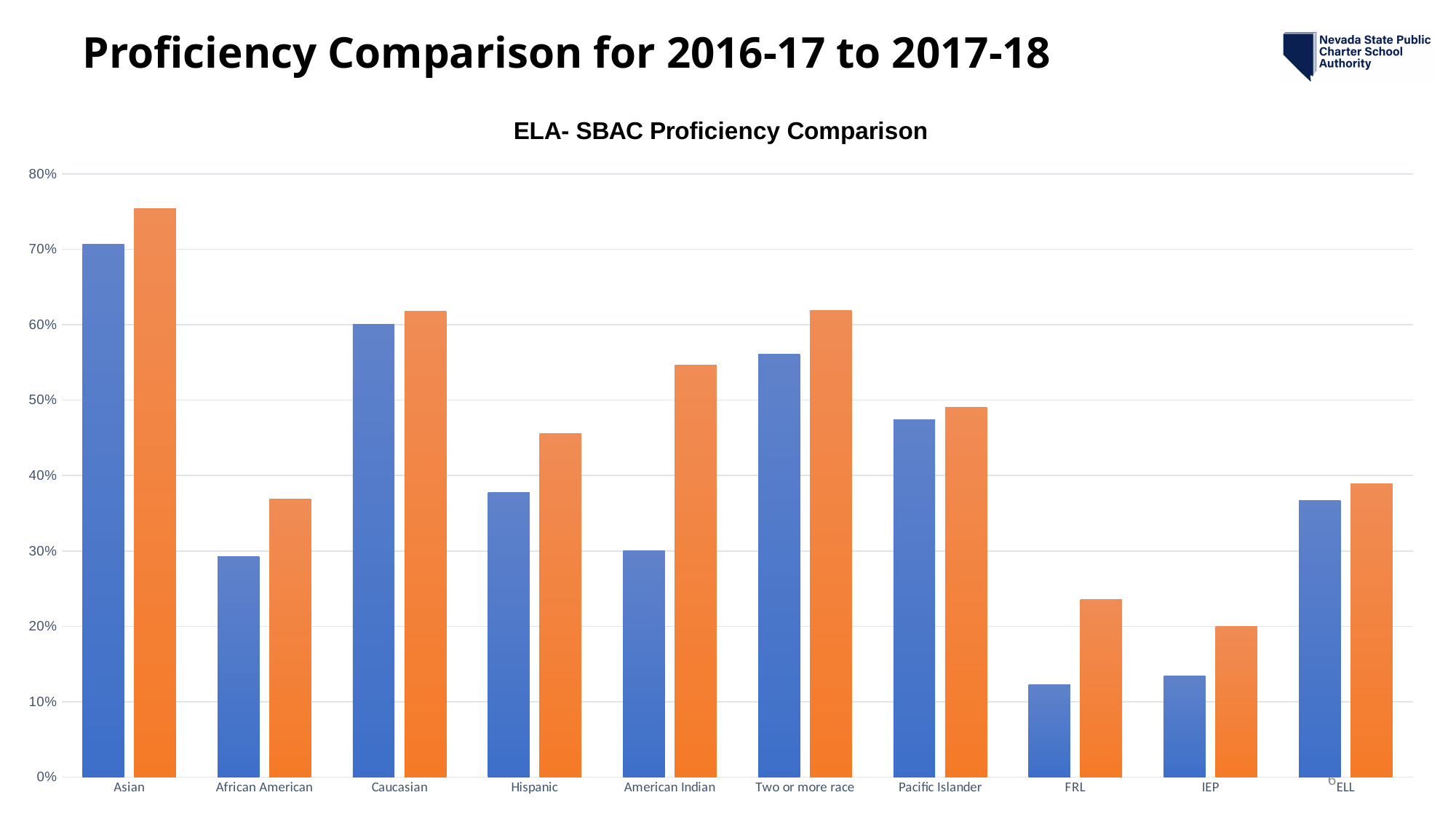
Which category has the tallest orange bar? Asian What type of chart is shown on the slide? Bar chart Is the orange bar for Hispanic greater or less than 40%? greater How many categories are shown along the x axis of the chart? 10 Which has the taller blue bar, Hispanic or American Indian? Hispanic Which category has the tallest blue bar? Asian Is the orange bar for Asian greater or less than 70%? greater Is the orange bar for Two or more race greater or less than 60%? greater Which category has the shortest orange bar? IEP What is the title of the chart? ELA- SBAC Proficiency Comparison In every category, is the orange bar taller or shorter than the blue bar? Taller